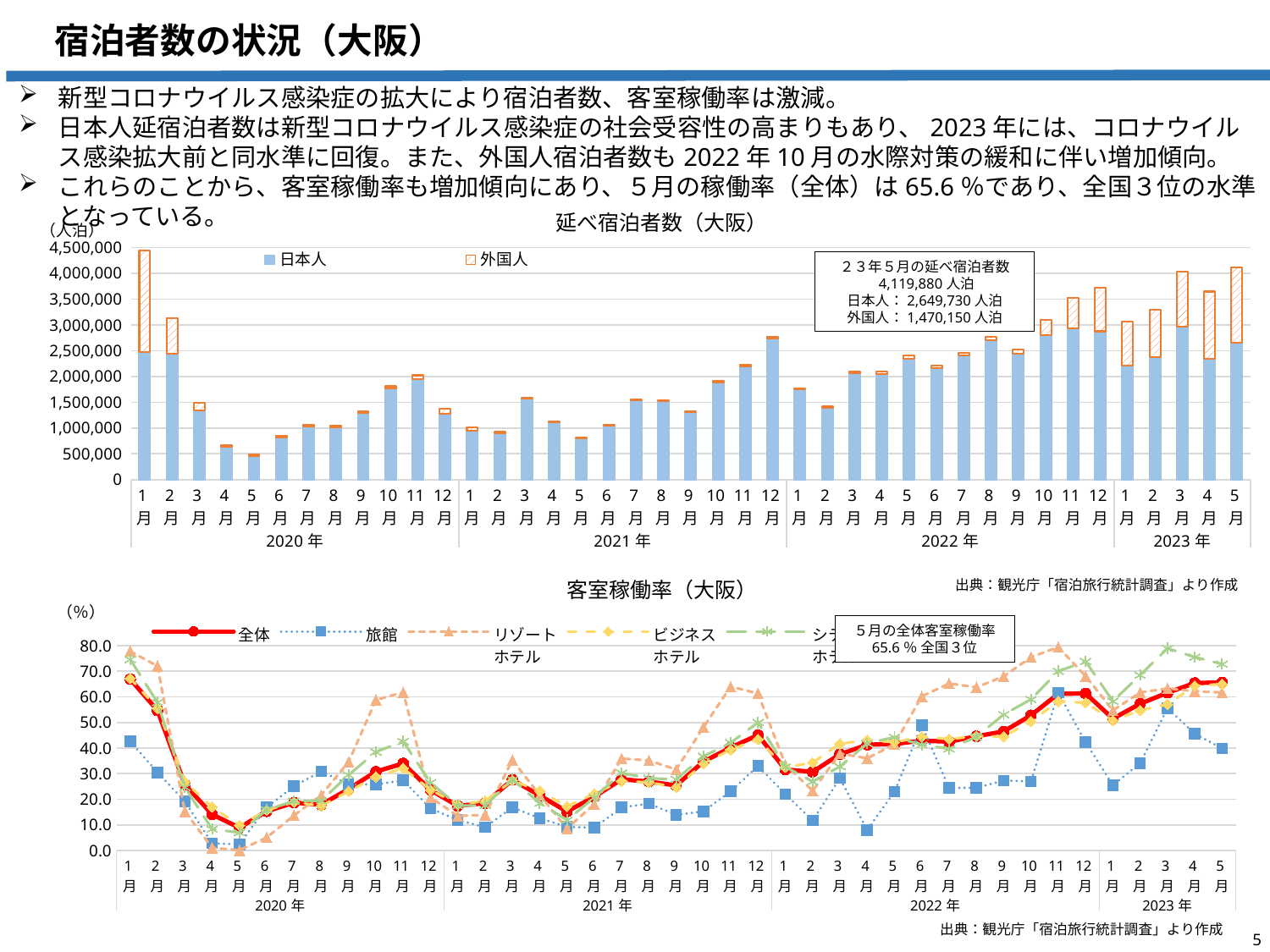
In the top chart 延べ宿泊者数（大阪）, how many series does the legend list? 2 In the top chart 延べ宿泊者数（大阪）, is the total bar for 2020年5月 greater or less than 1,000,000? less What kind of chart is the bottom chart titled 客室稼働率（大阪）? line chart What kind of chart is the top chart titled 延べ宿泊者数（大阪）? bar chart In the top chart 延べ宿泊者数（大阪）, what is the 日本人 value for 2023年5月 according to the annotation box? 2,649,730 人泊 In the top chart 延べ宿泊者数（大阪）, how much larger is the 日本人 value than the 外国人 value for 2023年5月? 1,179,580 人泊 In the top chart 延べ宿泊者数（大阪）, which month has the lowest total bar? 2020年5月 In the top chart 延べ宿泊者数（大阪）, what is the 外国人 value for 2023年5月 according to the annotation box? 1,470,150 人泊 In the bottom chart 客室稼働率（大阪）, what is the 全体 occupancy rate for 2023年5月 according to the annotation box? 65.6 % In the top chart 延べ宿泊者数（大阪）, which total bar is taller: 2020年1月 or 2020年2月? 2020年1月 In the bottom chart 客室稼働率（大阪）, how many series does the legend list? 5 In the top chart 延べ宿泊者数（大阪）, what is the total number of 延べ宿泊者数 for 2023年5月 according to the annotation box? 4,119,880 人泊